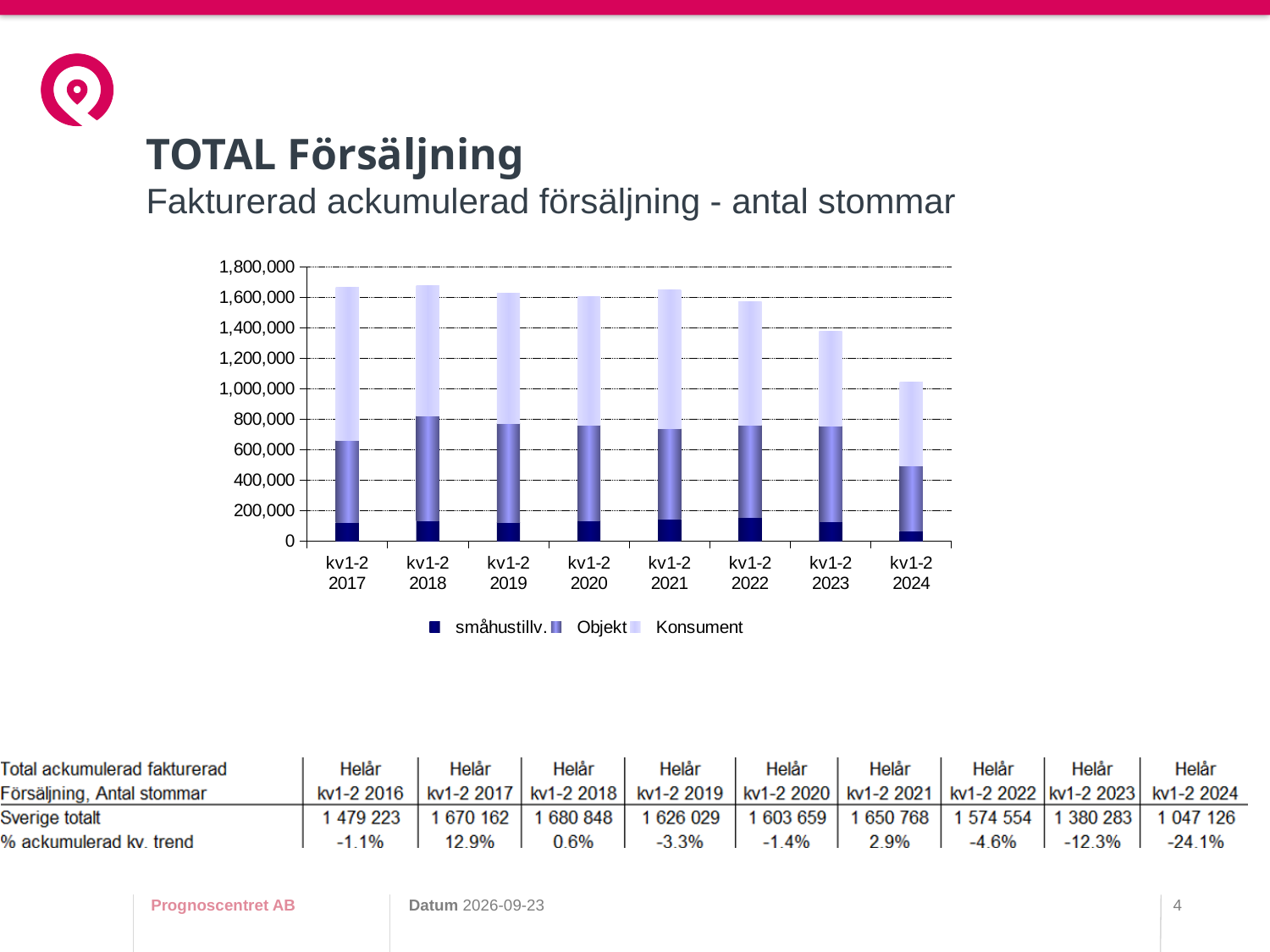
Which total bar is larger, kv1-2 2022 or kv1-2 2023? kv1-2 2022 What kind of chart is shown on the slide? stacked bar chart Which period has the lowest total bar in the chart? kv1-2 2024 Which series is shown in the lightest colour at the top of each stacked bar? Konsument How many series does the chart legend list? 3 Do the total bars rise or fall from kv1-2 2021 to kv1-2 2024? fall According to the table below the chart, what is the total 'Sverige totalt' for kv1-2 2024? 1 047 126 How many periods (bars) are plotted along the x axis of the chart? 8 Is the total bar for kv1-2 2024 greater or less than 1,200,000? less Which total bar is larger, kv1-2 2023 or kv1-2 2024? kv1-2 2023 Is the total bar for kv1-2 2017 greater or less than 1,600,000? greater Is the total bar for kv1-2 2023 greater or less than 1,200,000? greater